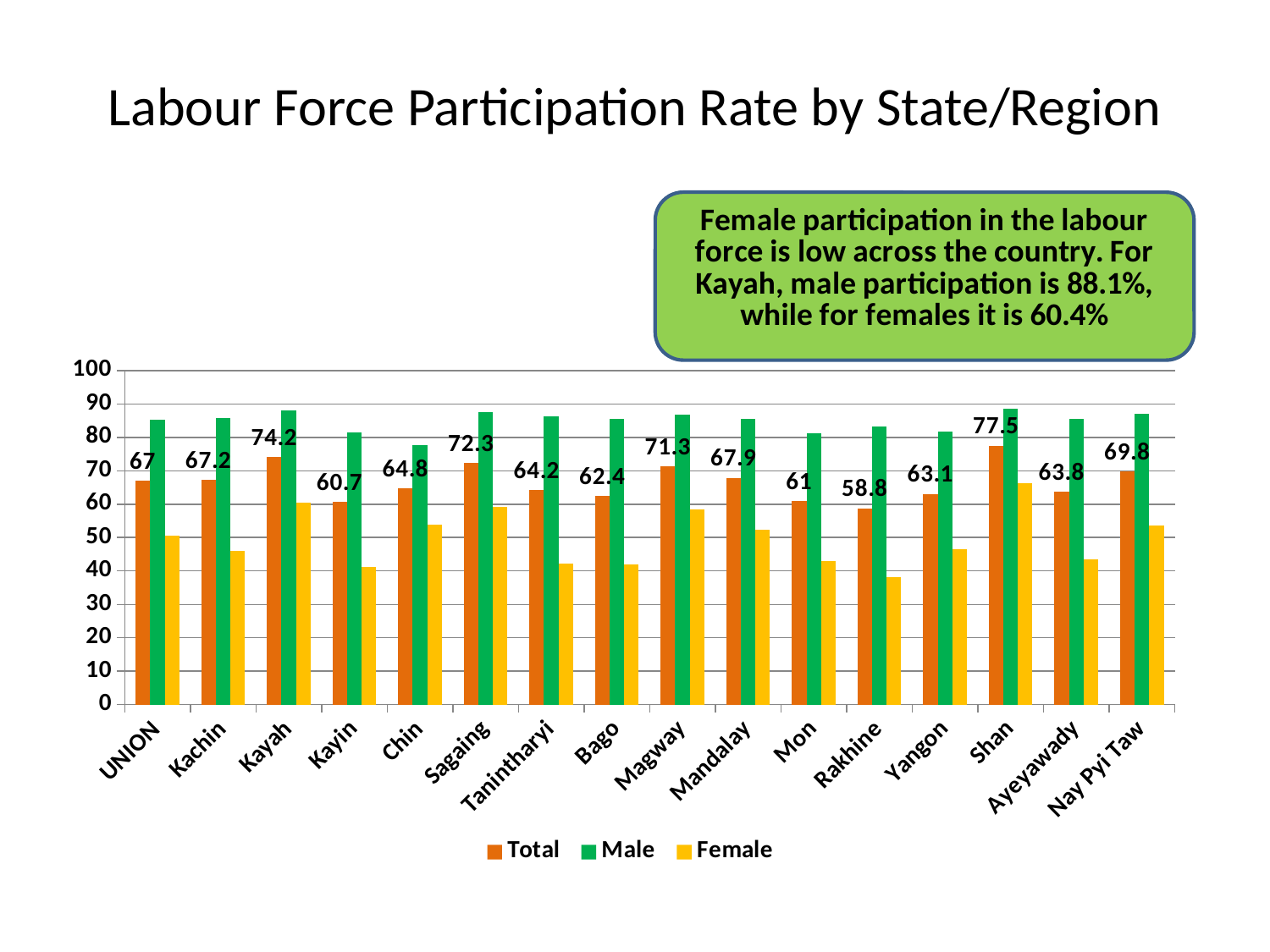
How many states/regions (including UNION) are shown on the x axis? 16 Which state/region has the highest Total labour force participation rate? Shan Is the Male value for Kayin greater or less than 90? less Is the Female value for Shan greater or less than 60? greater What is the difference between the Total rates for Shan and Rakhine? 18.7 Which state/region has the lowest Total labour force participation rate? Rakhine What is the Total labour force participation rate for Shan? 77.5 What kind of chart is shown on the slide? Bar chart What is the Total labour force participation rate for Rakhine? 58.8 How many series does the legend list? 3 Which has a higher Total rate, Kayah or Sagaing? Kayah What is the Total labour force participation rate for UNION? 67